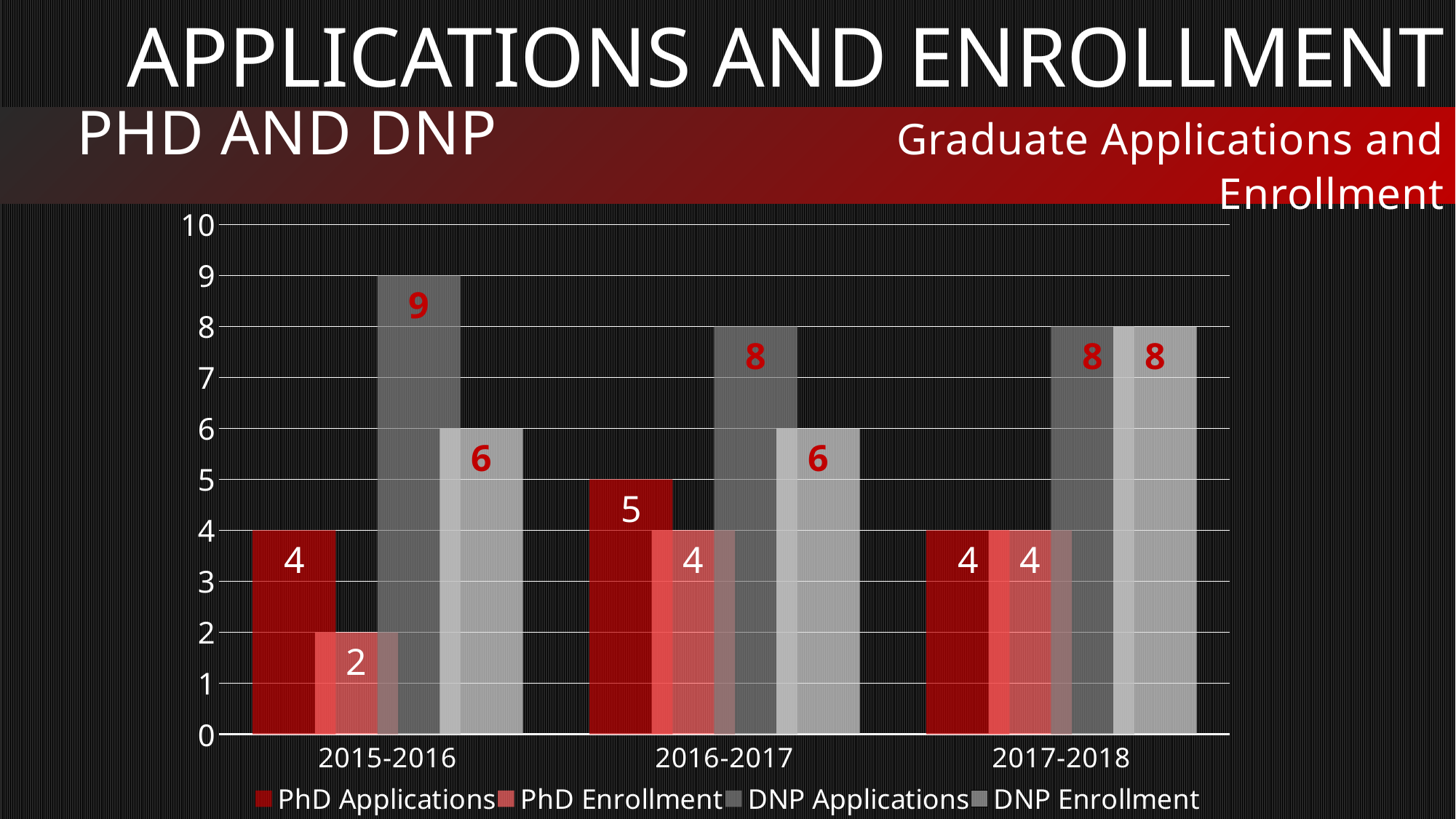
What kind of chart is shown on the slide? Bar chart Which year has the highest value for DNP Applications? 2015-2016 What is the value for DNP Applications in 2015-2016? 9 Does the value for DNP Enrollment rise or fall from 2015-2016 to 2017-2018? Rise What is the value for PhD Enrollment in 2015-2016? 2 How many year categories are shown on the x axis? 3 How many series does the legend list? 4 What is the difference between DNP Applications and PhD Applications in 2015-2016? 5 Which is larger in 2016-2017, DNP Applications or DNP Enrollment? DNP Applications What is the value for DNP Enrollment in 2017-2018? 8 Which year has the lowest value for PhD Enrollment? 2015-2016 What is the value for PhD Applications in 2016-2017? 5